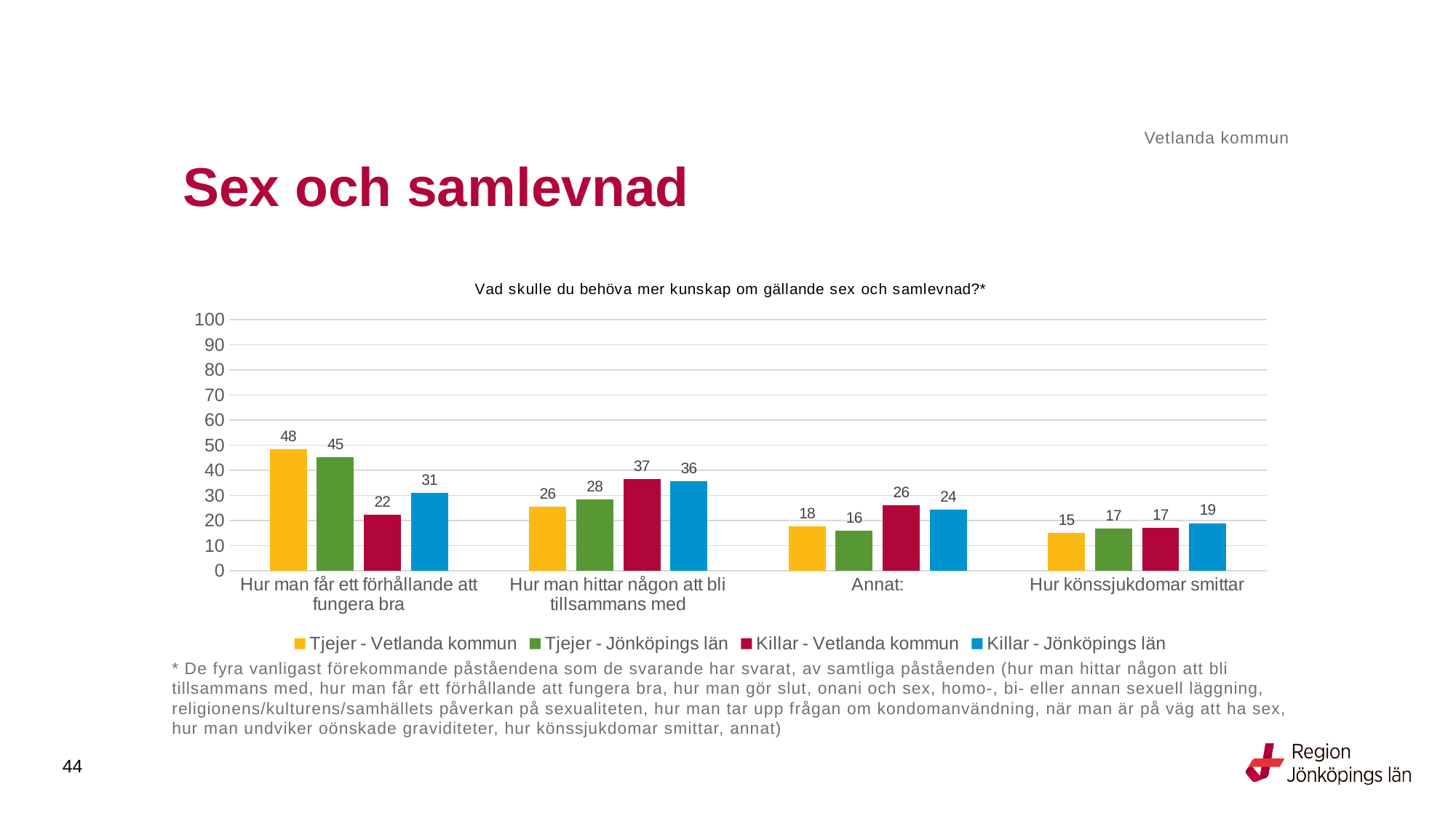
What is the value for Killar - Jönköpings län in the category 'Annat:'? 24 How many series does the legend list? 4 What is the difference between Tjejer - Vetlanda kommun and Killar - Vetlanda kommun in the category 'Hur man får ett förhållande att fungera bra'? 26 What is the title of the chart? Vad skulle du behöva mer kunskap om gällande sex och samlevnad?* What is the value for Tjejer - Vetlanda kommun in the category 'Hur man får ett förhållande att fungera bra'? 48 Is the value for Killar - Jönköpings län in 'Hur man får ett förhållande att fungera bra' greater or less than 40? less How many categories are shown on the x axis? 4 What is the value for Killar - Vetlanda kommun in the category 'Hur man hittar någon att bli tillsammans med'? 37 Which category has the lowest value for Tjejer - Vetlanda kommun? Hur könssjukdomar smittar Which category has the highest value for Tjejer - Jönköpings län? Hur man får ett förhållande att fungera bra What kind of chart is shown on the slide? Bar chart In the category 'Hur man hittar någon att bli tillsammans med', which is larger: Tjejer - Vetlanda kommun or Killar - Jönköpings län? Killar - Jönköpings län